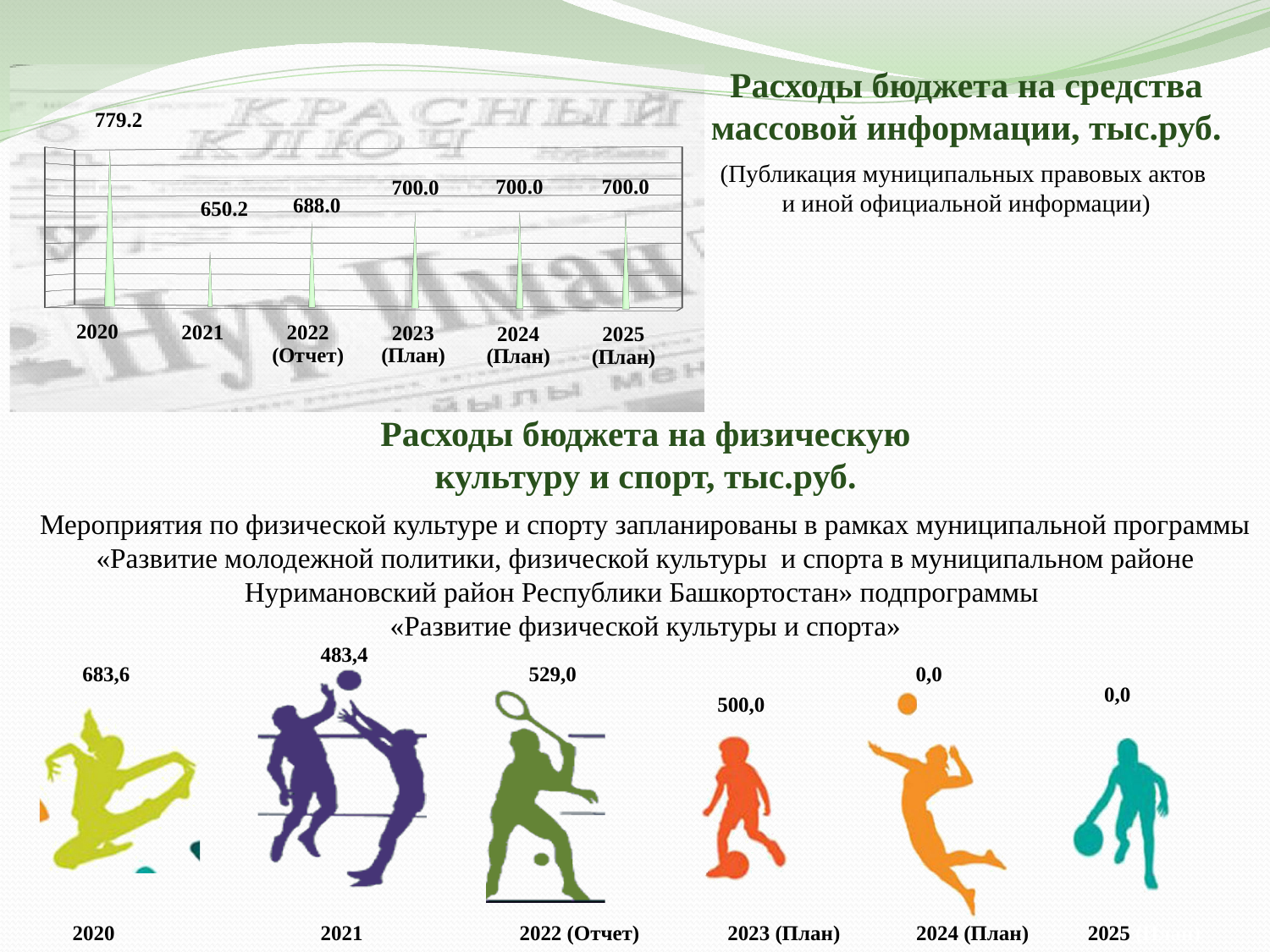
In the chart 'Расходы бюджета на средства массовой информации, тыс.руб.', which is larger: the value for 2021 or the value for 2022 (Отчет)? 2022 (Отчет) In the chart 'Расходы бюджета на средства массовой информации, тыс.руб.', which year has the lowest value? 2021 In the infographic 'Расходы бюджета на физическую культуру и спорт, тыс.руб.', which year has the highest value? 2020 In the chart 'Расходы бюджета на средства массовой информации, тыс.руб.', what is the difference between the values for 2020 and 2021? 129.0 In the chart 'Расходы бюджета на средства массовой информации, тыс.руб.', what is the value for 2024 (План)? 700.0 In the chart 'Расходы бюджета на средства массовой информации, тыс.руб.', what is the value for 2020? 779.2 In the chart 'Расходы бюджета на средства массовой информации, тыс.руб.', which year has the highest value? 2020 In the infographic 'Расходы бюджета на физическую культуру и спорт, тыс.руб.', what is the value for 2021? 483,4 In the chart 'Расходы бюджета на средства массовой информации, тыс.руб.', what is the value for 2022 (Отчет)? 688.0 What kind of chart is 'Расходы бюджета на средства массовой информации, тыс.руб.'? bar chart How many years are shown in the chart 'Расходы бюджета на средства массовой информации, тыс.руб.'? 6 In the chart 'Расходы бюджета на средства массовой информации, тыс.руб.', do the values change from 2023 (План) to 2025 (План)? No, they stay at 700.0